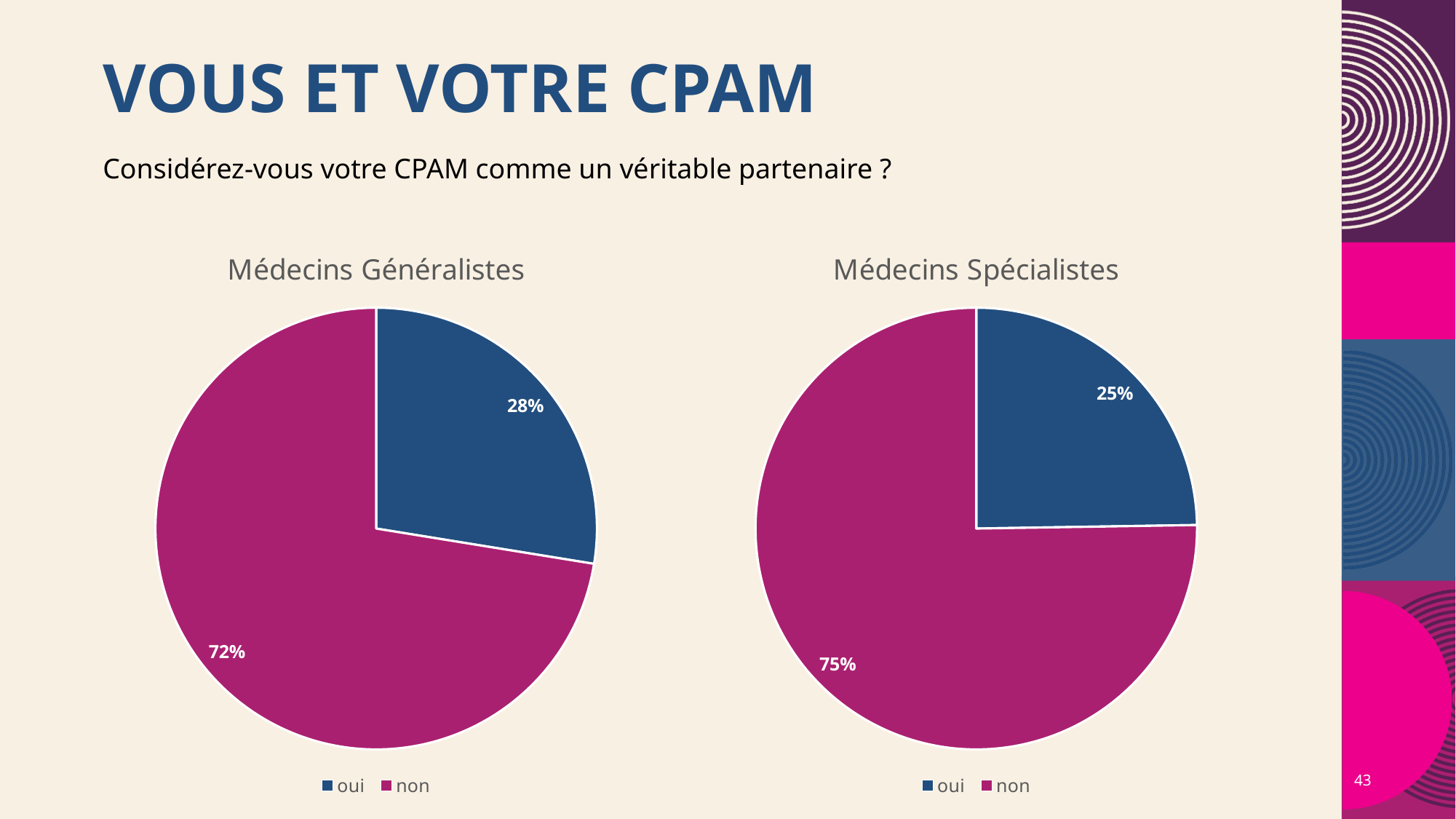
In the 'Médecins Spécialistes' chart, which answer has the smallest slice? oui How many slices does the 'Médecins Généralistes' pie chart have? 2 In the 'Médecins Spécialistes' chart, what percentage answered 'oui'? 25% In the 'Médecins Généralistes' chart, which answer has the largest slice? non Is the 'oui' share larger in the 'Médecins Généralistes' chart or the 'Médecins Spécialistes' chart? Médecins Généralistes In the 'Médecins Généralistes' chart, what colour is the 'non' slice? Magenta In the 'Médecins Généralistes' chart, what percentage answered 'oui'? 28% What type of chart is the 'Médecins Spécialistes' chart? Pie chart In the 'Médecins Spécialistes' chart, what percentage answered 'non'? 75% In the 'Médecins Généralistes' chart, what is the difference between the 'non' and 'oui' percentages? 44% How many entries does the legend of the 'Médecins Spécialistes' chart list? 2 In the 'Médecins Généralistes' chart, what percentage answered 'non'? 72%